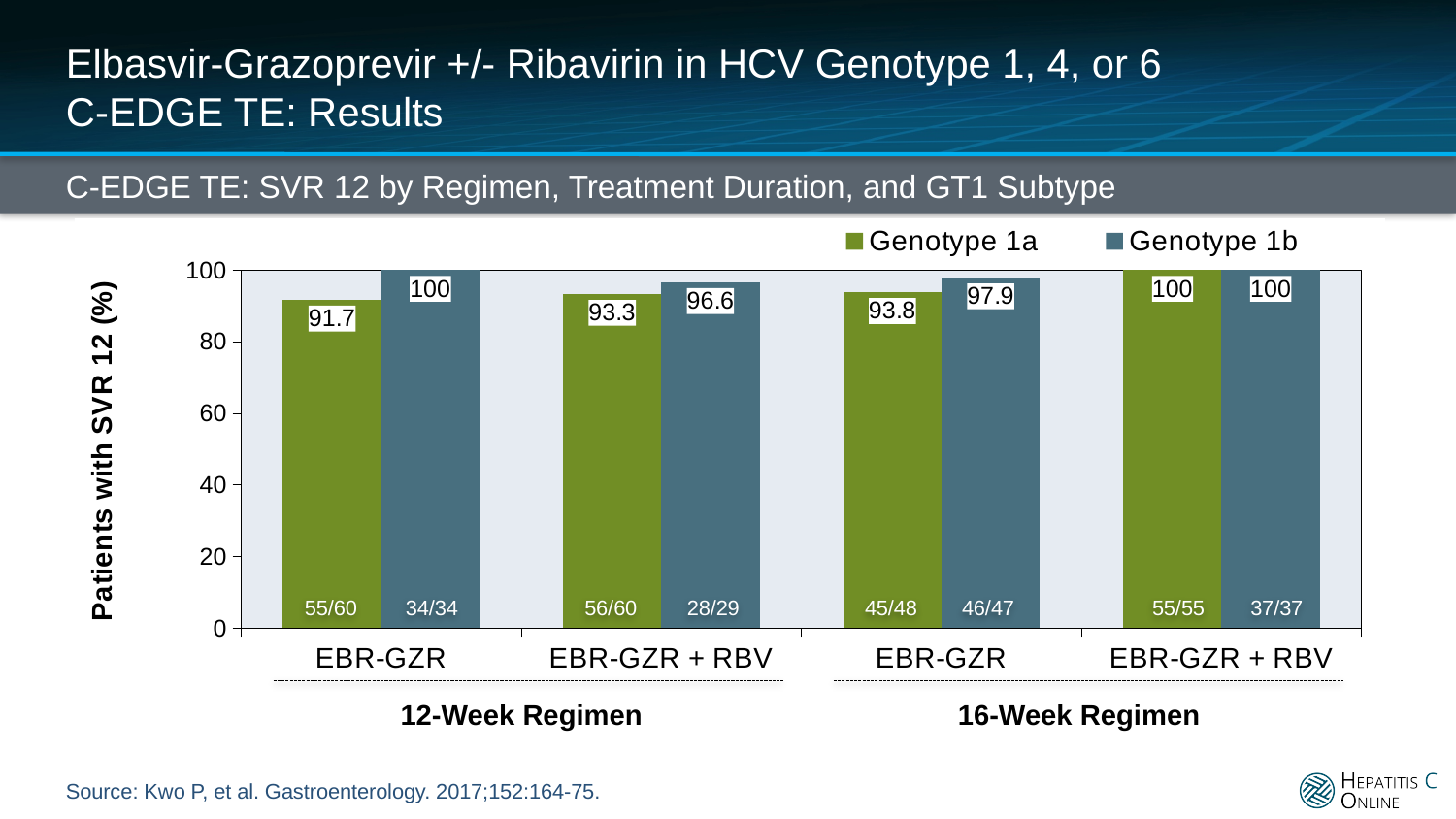
What is the label of the y axis? Patients with SVR 12 (%) What is the SVR 12 rate for Genotype 1b with EBR-GZR in the 16-Week Regimen? 97.9 What is the SVR 12 rate for Genotype 1a with EBR-GZR in the 12-Week Regimen? 91.7 How many patients achieved SVR 12 out of the total for Genotype 1b with EBR-GZR + RBV in the 12-Week Regimen? 28/29 What is the SVR 12 rate for Genotype 1a with EBR-GZR in the 16-Week Regimen? 93.8 Which is larger for EBR-GZR + RBV in the 12-Week Regimen: the Genotype 1a or the Genotype 1b SVR 12 rate? Genotype 1b What is the difference between the Genotype 1b and Genotype 1a SVR 12 rates for EBR-GZR in the 12-Week Regimen? 8.3 How many series does the legend list? 2 How many regimen groups are shown on the x axis of the chart? 4 What is the SVR 12 rate for Genotype 1b with EBR-GZR + RBV in the 12-Week Regimen? 96.6 Which regimen and duration has the lowest SVR 12 rate for Genotype 1a? EBR-GZR, 12-Week Regimen What kind of chart is shown on the slide? Bar chart